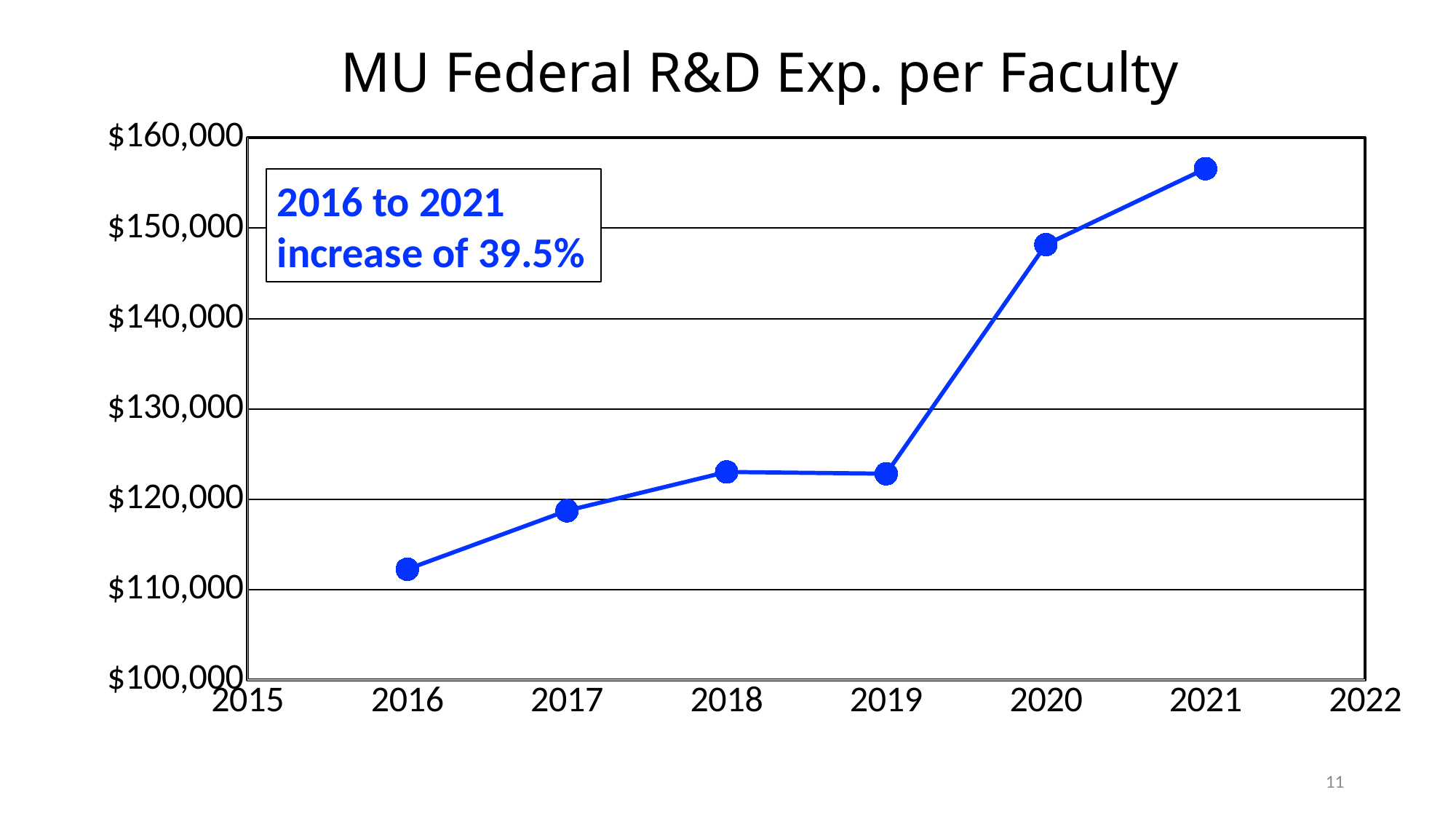
Is the value for 2021 greater or less than $150,000? greater Is the value for 2018 greater or less than $130,000? less Is the value for 2016 greater or less than $120,000? less Which year has the highest federal R&D expenditure per faculty? 2021 Which year has the larger value, 2017 or 2020? 2020 According to the annotation on the chart, what was the percentage increase from 2016 to 2021? 39.5% What is the title of the chart? MU Federal R&D Exp. per Faculty Do the values generally rise or fall from 2016 to 2021? rise What kind of chart is shown on the slide? line chart How many data points are plotted on the line? 6 Which year has the lowest federal R&D expenditure per faculty? 2016